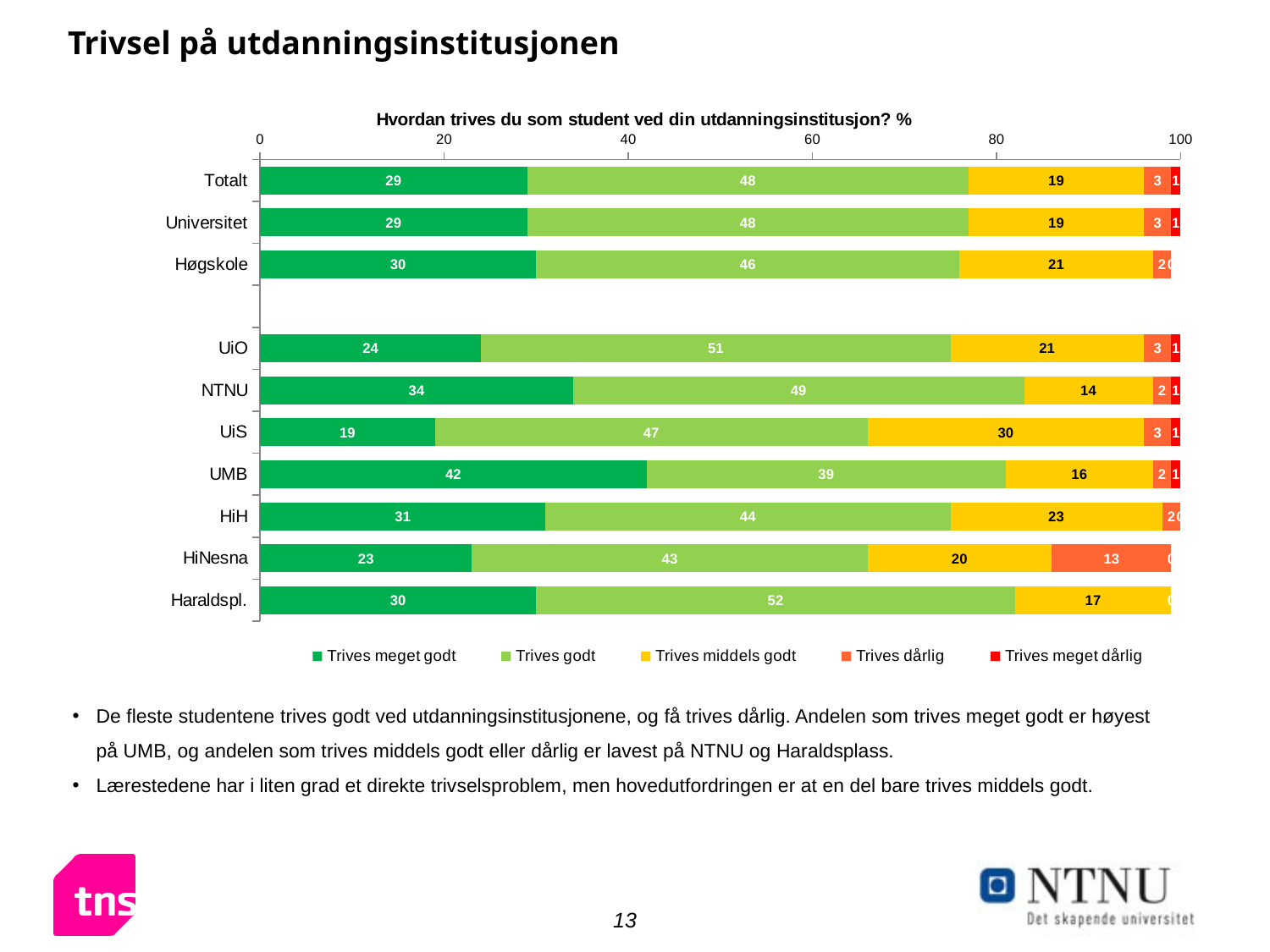
How many institutions or groups are plotted on the y axis? 10 Which category has the lowest value for 'Trives meget godt'? UiS Which category has the highest value for 'Trives meget godt'? UMB What is the value for 'Trives middels godt' at NTNU? 14 How many series does the legend list? 5 Which has the larger 'Trives godt' value, Haraldspl. or UMB? Haraldspl. What is the title of the chart? Hvordan trives du som student ved din utdanningsinstitusjon? % What is the value for 'Trives meget godt' at UMB? 42 What is the difference between the 'Trives meget godt' values for UMB and UiS? 23 What is the value for 'Trives middels godt' at UiS? 30 Which category has the highest value for 'Trives godt'? Haraldspl. What kind of chart is shown on the slide? bar chart